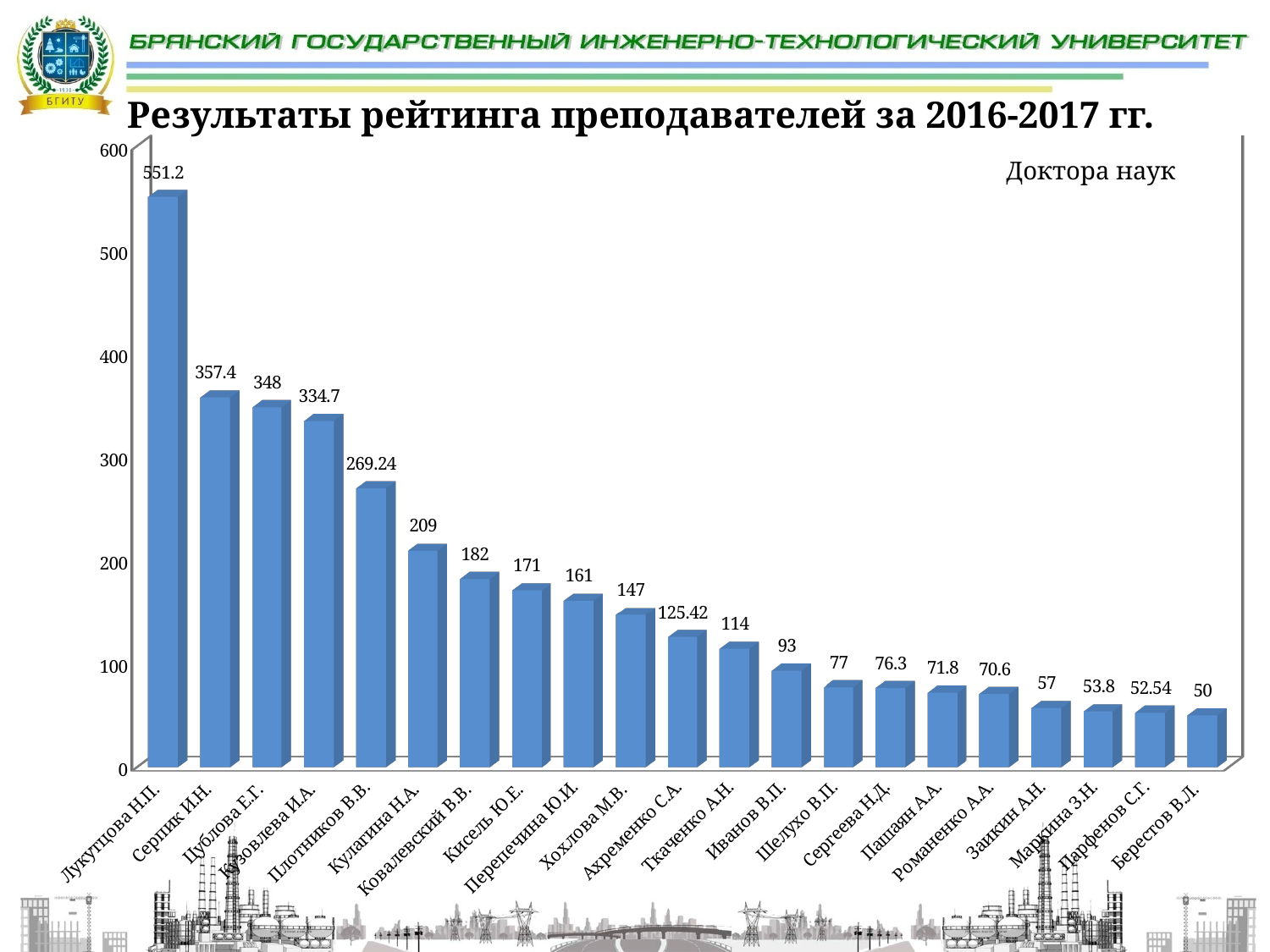
What is the value for Лукутцова Н.П.? 551.2 Which category has the highest value? Лукутцова Н.П. What is the value for Парфенов С.Г.? 52.54 Which is larger, the value for Кулагина Н.А. or the value for Ковалевский В.В.? Кулагина Н.А. What is the difference between the values for Серпик И.Н. and Цублова Е.Г.? 9.4 What is the value for Плотников В.В.? 269.24 Do the values rise or fall from left to right along the x axis? fall How many categories are shown on the x axis? 21 What kind of chart is shown on the slide? bar chart What is the value for Ахременко С.А.? 125.42 Is the value for Кузовлева И.А. greater or less than 300? greater Which category has the lowest value? Берестов В.Л.